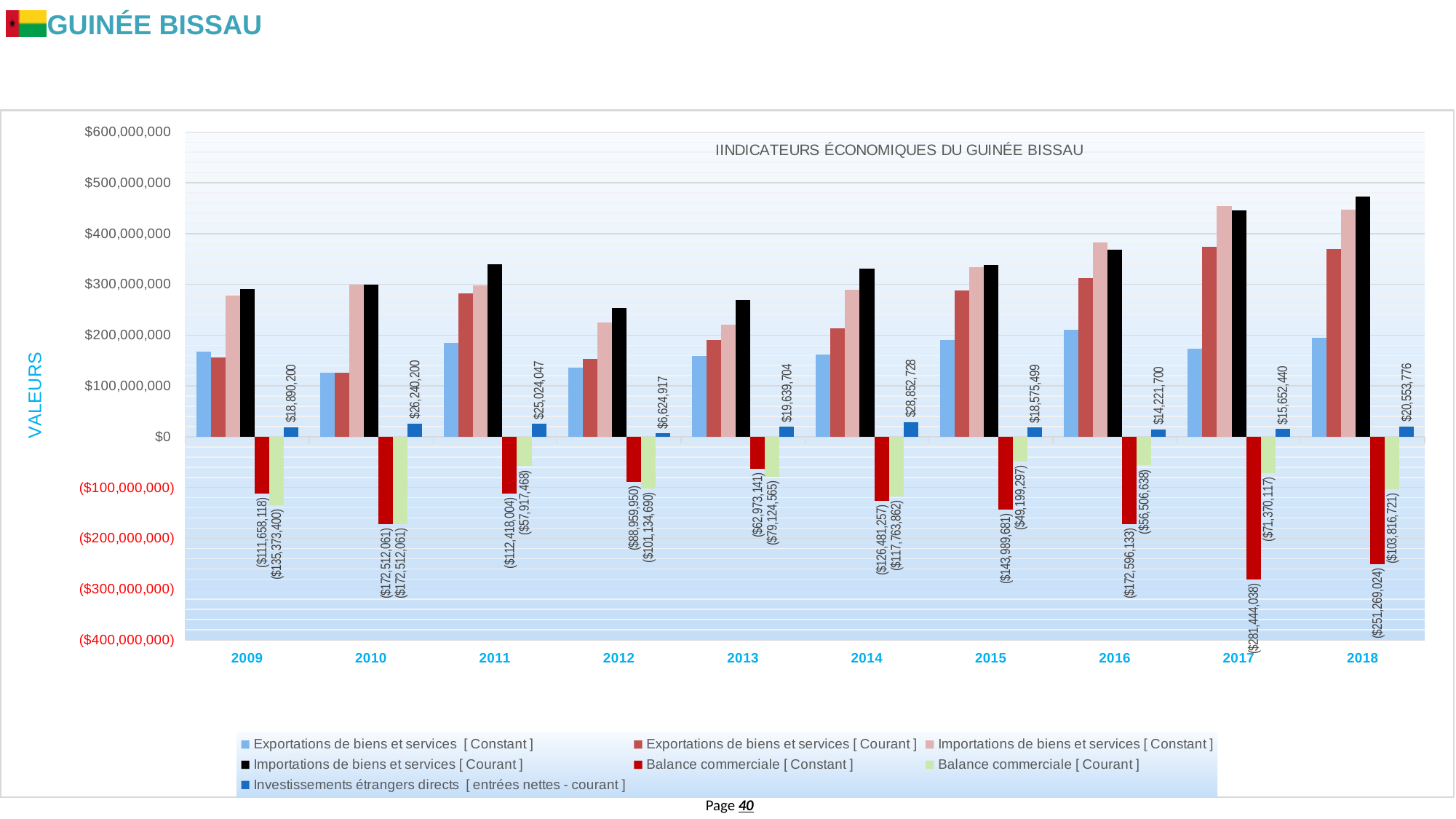
In which year is Investissements étrangers directs the lowest? 2012 What is the value of Balance commerciale [ Constant ] for 2017? ($281,444,038) What is the value of Investissements étrangers directs for 2014? $28,852,728 Which year has the larger value of Investissements étrangers directs, 2013 or 2016? 2013 By how much did Investissements étrangers directs increase from 2009 to 2010? $7,350,000 In which year is Investissements étrangers directs the highest? 2014 Is the value of Importations de biens et services [ Courant ] for 2018 greater or less than $400,000,000? greater What kind of chart is shown on the slide? bar chart What is the value of Balance commerciale [ Courant ] for 2011? ($57,917,468) How many years are shown on the x axis? 10 How many series does the legend list? 7 Is the value of Exportations de biens et services [ Constant ] for 2010 greater or less than $200,000,000? less